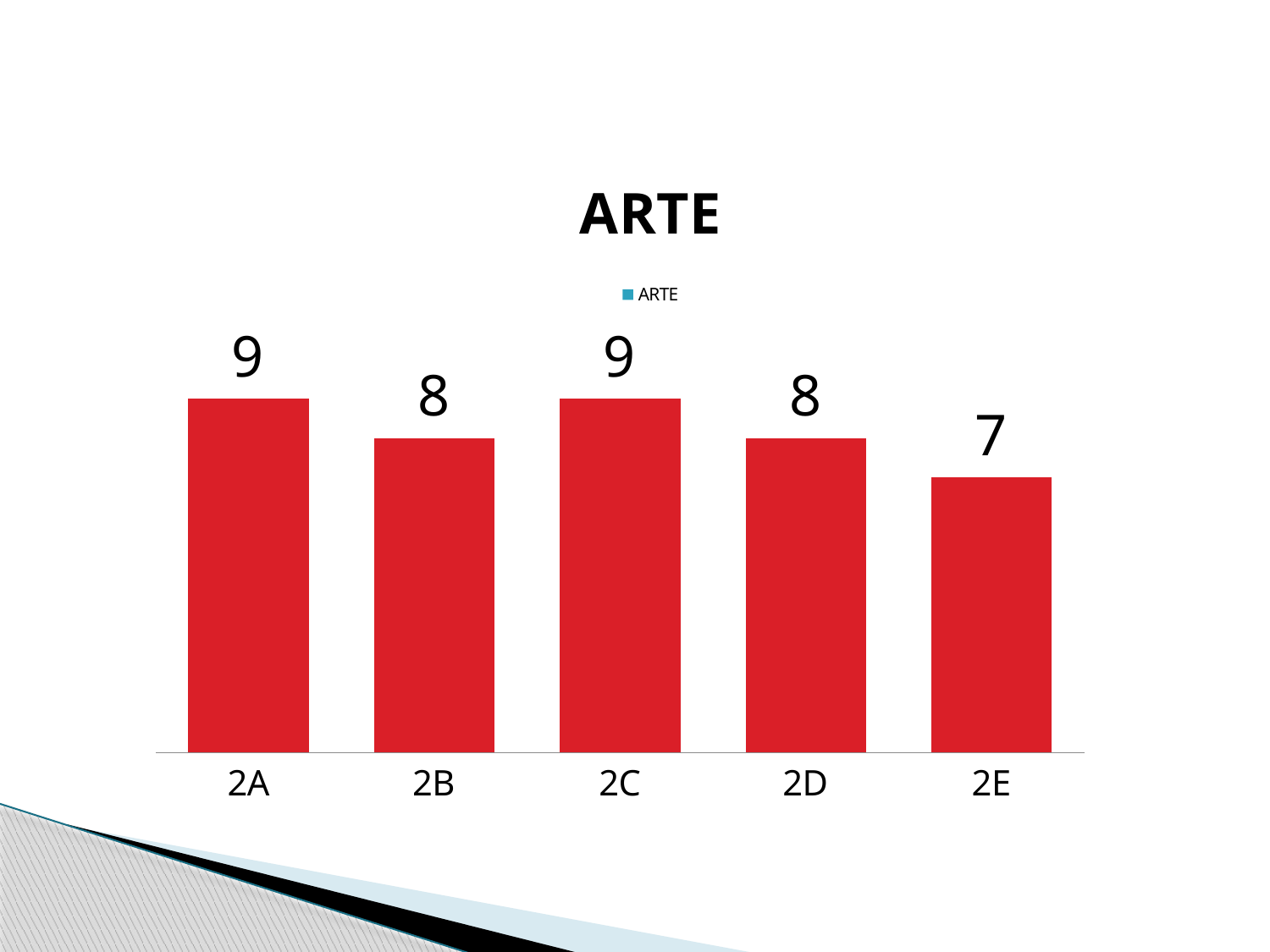
What is the value for 2B? 8 What is the difference between the values for 2C and 2D? 1 Which is larger, the value for 2B or the value for 2E? 2B What is the title of the chart? ARTE What is the value for 2E? 7 What is the value for 2D? 8 How many categories are shown on the x axis? 5 What is the value for 2A? 9 Which category has the lowest value? 2E How many series does the legend list? 1 What is the difference between the values for 2A and 2E? 2 What kind of chart is shown? bar chart